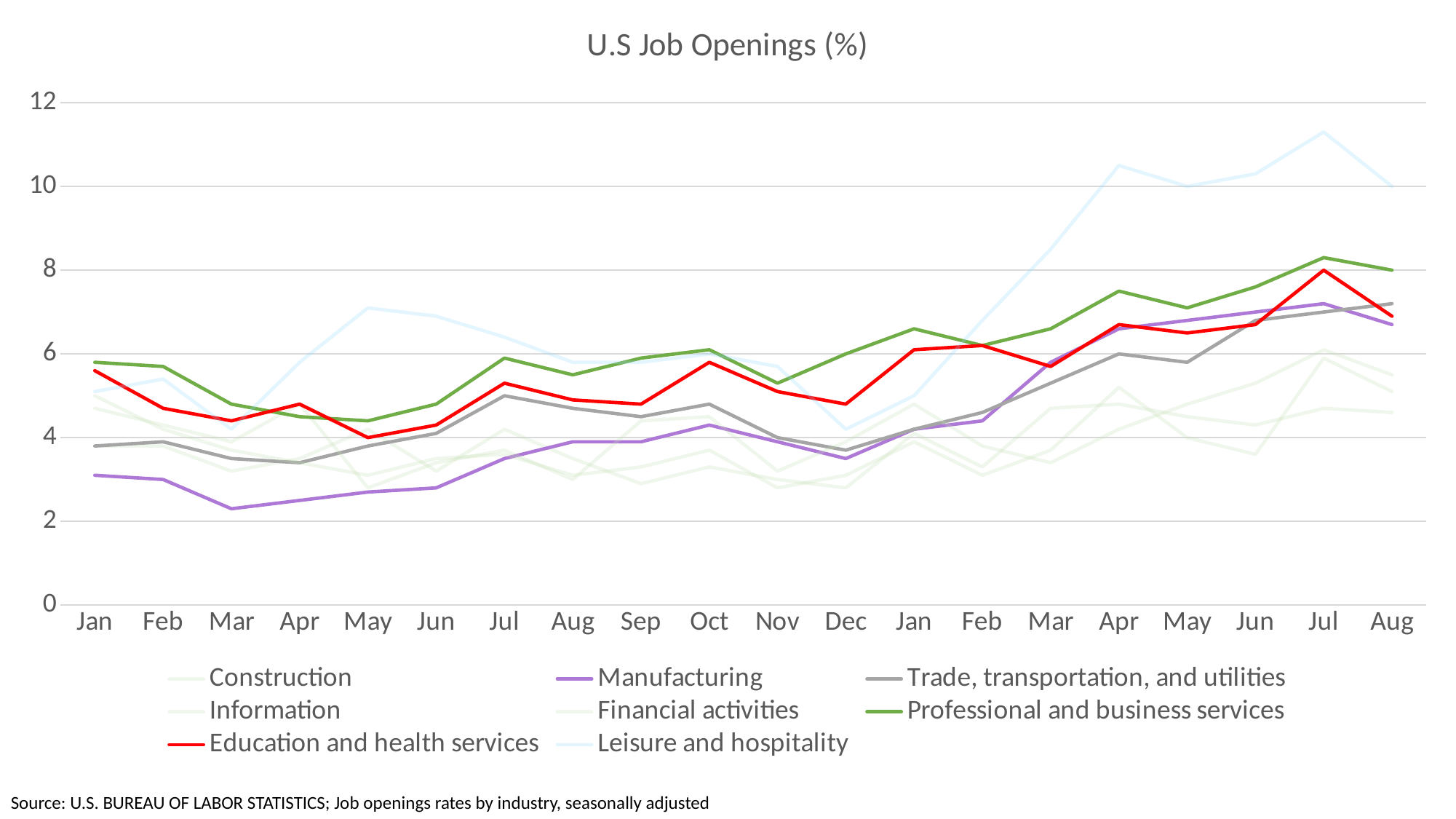
In the second Apr, which is larger: Leisure and hospitality or Professional and business services? Leisure and hospitality How many series does the legend list? 8 Is the value for Manufacturing in the first Mar greater or less than 4? less Does the Manufacturing line generally rise or fall from the first Jan to the final Aug? Rise What kind of chart is shown on the slide? Line chart How many months are shown along the x axis? 20 Which series has the highest value in the final Aug? Leisure and hospitality In Dec, which is larger: Professional and business services or Education and health services? Professional and business services What is the title of the chart? U.S Job Openings (%) Which series has the lowest value in the first Jan? Manufacturing Is the value for Education and health services in Dec greater or less than 6? less Is the value for Leisure and hospitality in the second Jul greater or less than 10? greater